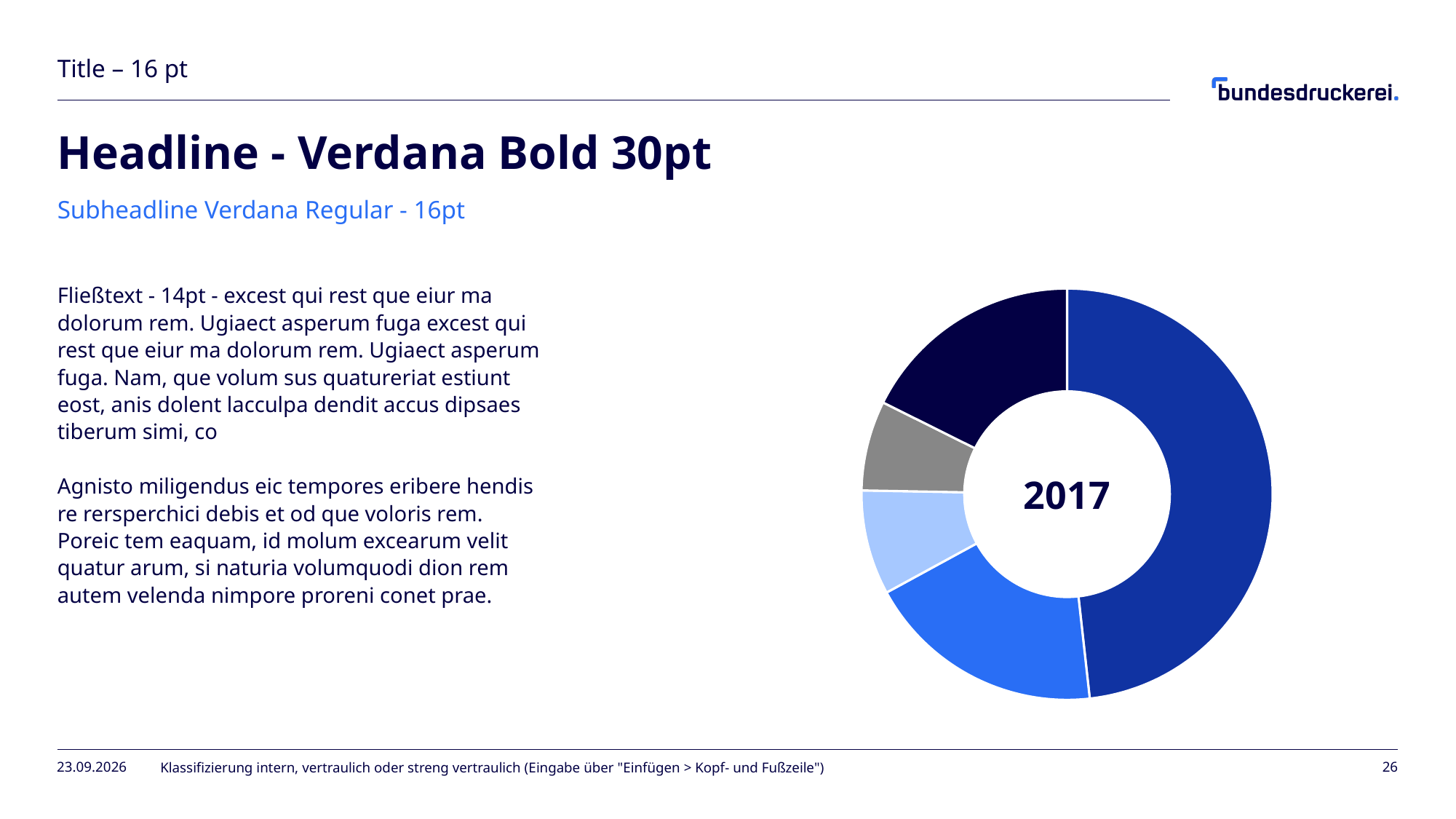
How many slices does the donut chart have? 5 Which colour slice is the largest in the donut chart? Dark blue Is the medium blue slice larger or smaller than the light blue slice? Larger Does the donut chart show a legend? No What text is shown in the centre of the donut chart? 2017 Is the dark blue slice larger or smaller than the grey slice? Larger What kind of chart is shown on the slide? Donut (pie) chart